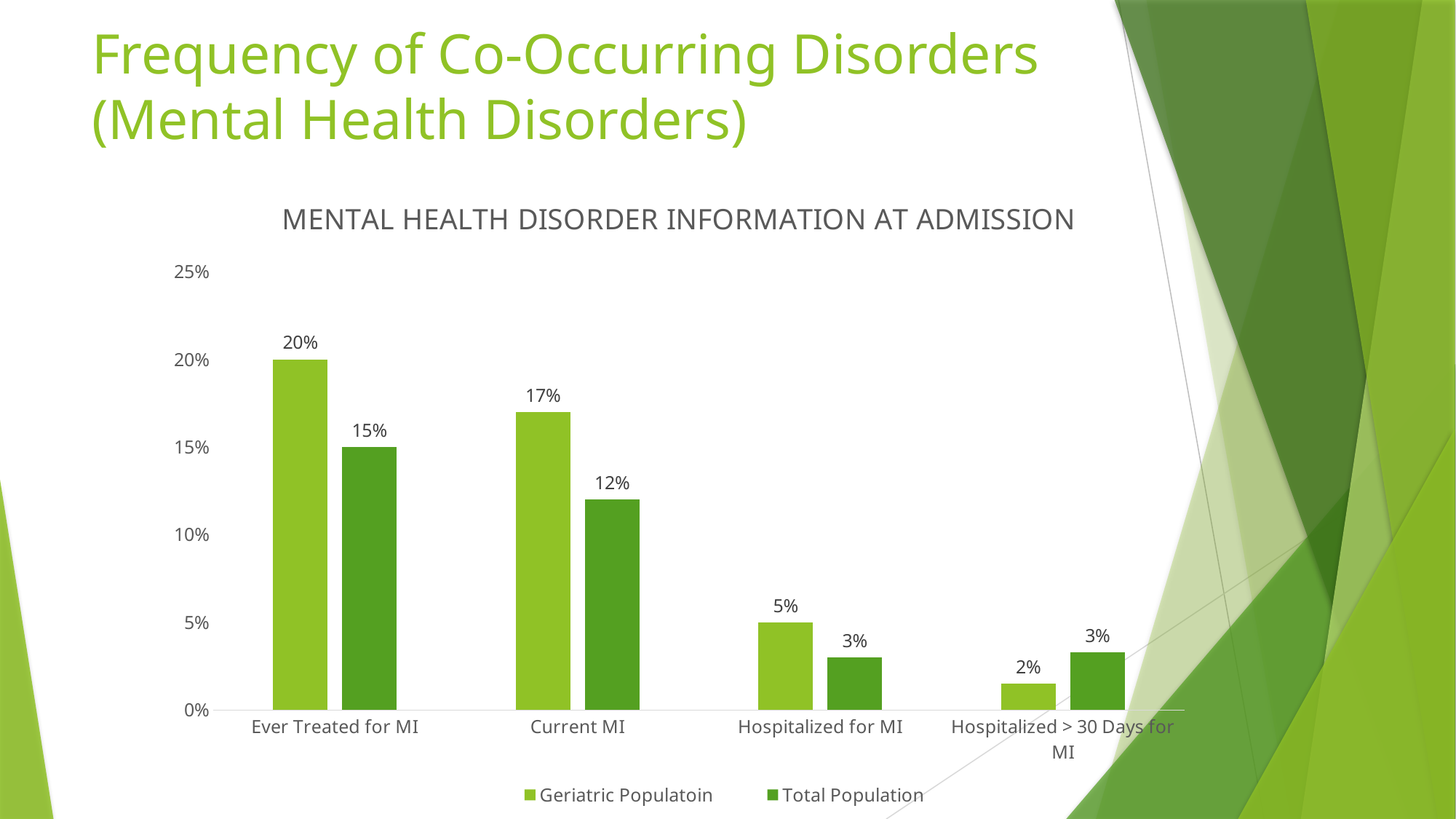
What is the value for the Geriatric Population in the Hospitalized > 30 Days for MI category? 2% How many categories are shown on the x axis? 4 What is the title of the chart? MENTAL HEALTH DISORDER INFORMATION AT ADMISSION What kind of chart is shown on the slide? Bar chart What is the difference between the Geriatric Population values for Current MI and Hospitalized for MI? 12% In the Hospitalized > 30 Days for MI category, which series has the larger value? Total Population Which category has the highest value for the Geriatric Population? Ever Treated for MI What is the difference between the Geriatric Population and Total Population values for Ever Treated for MI? 5% What is the value for the Geriatric Population in the Ever Treated for MI category? 20% Which category has the lowest value for the Total Population? Hospitalized for MI How many series does the legend list? 2 What is the value for the Total Population in the Current MI category? 12%